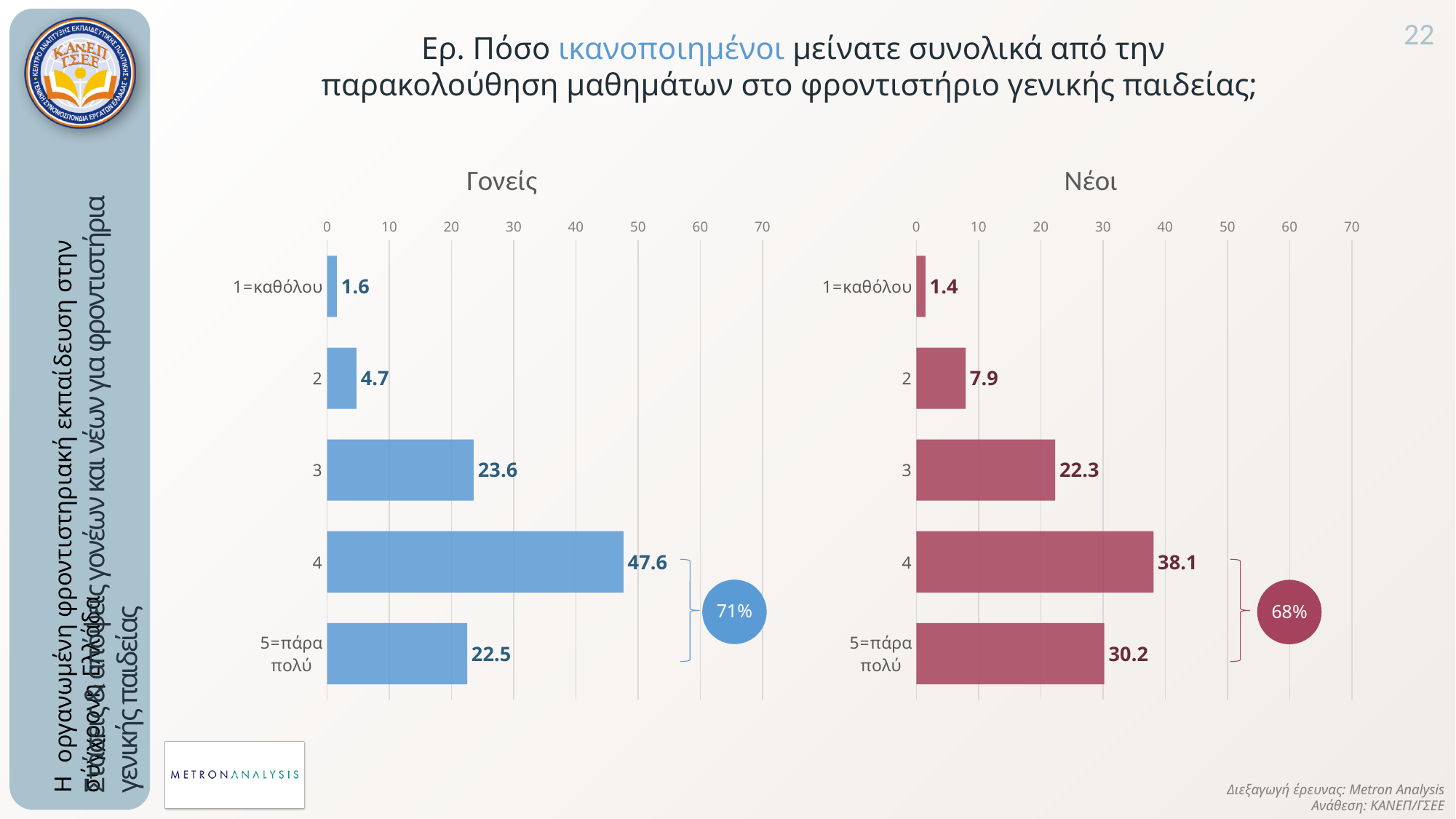
In the Νέοι chart, what is the value for 5=πάρα πολύ? 30.2 In the Γονείς chart, what is the value for category 4? 47.6 In the Νέοι chart, what is the value for category 2? 7.9 In the Νέοι chart, is the value for category 4 greater or less than 40? less In the Νέοι chart, which category has the lowest value? 1=καθόλου Which is larger: the value for category 3 in the Γονείς chart or the value for category 3 in the Νέοι chart? Γονείς How many categories are shown in the Γονείς chart? 5 What percentage is shown in the circle next to the Γονείς chart? 71% What kind of chart is the Νέοι chart? bar chart In the Νέοι chart, what is the difference between the values for category 4 and 5=πάρα πολύ? 7.9 In the Γονείς chart, what is the difference between the values for category 4 and category 3? 24.0 In the Γονείς chart, which category has the highest value? 4